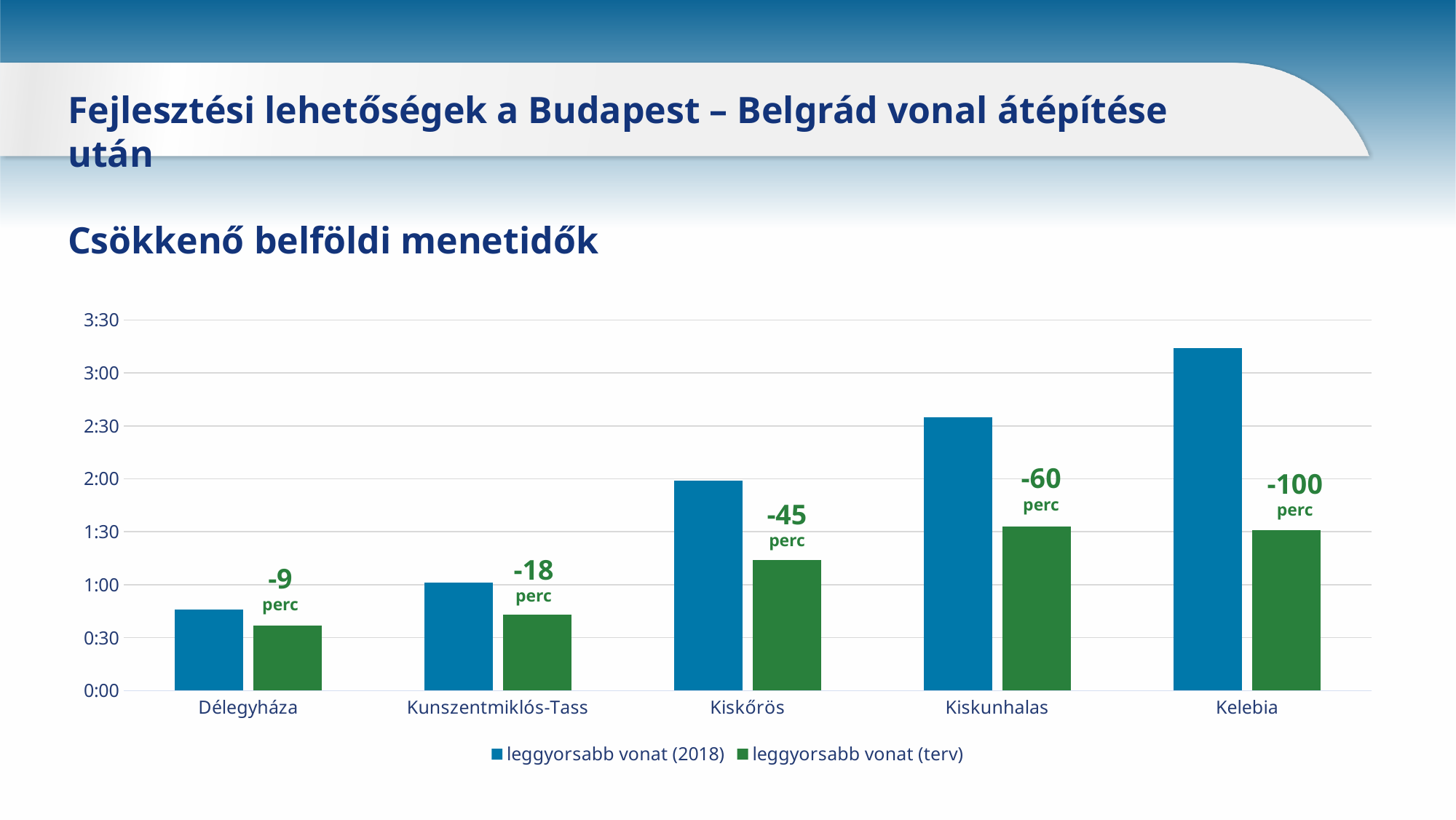
Which station has the lowest value for leggyorsabb vonat (terv)? Délegyháza What travel-time reduction is labelled above the bars for Kiskőrös? -45 perc What travel-time reduction is labelled above the bars for Kelebia? -100 perc Is the value for Kelebia in the leggyorsabb vonat (2018) series greater or less than 3:00? greater Is the value for Kiskőrös in the leggyorsabb vonat (terv) series greater or less than 1:30? less Which station has the highest value for leggyorsabb vonat (2018)? Kelebia What kind of chart is shown on the slide? bar chart How many stations (categories) are shown on the x axis of the chart? 5 Do the values for leggyorsabb vonat (2018) rise or fall from Délegyháza to Kelebia along the x axis? rise Which series is shown in green in the chart? leggyorsabb vonat (terv) What is the title of the chart? Csökkenő belföldi menetidők How many series does the chart's legend list? 2